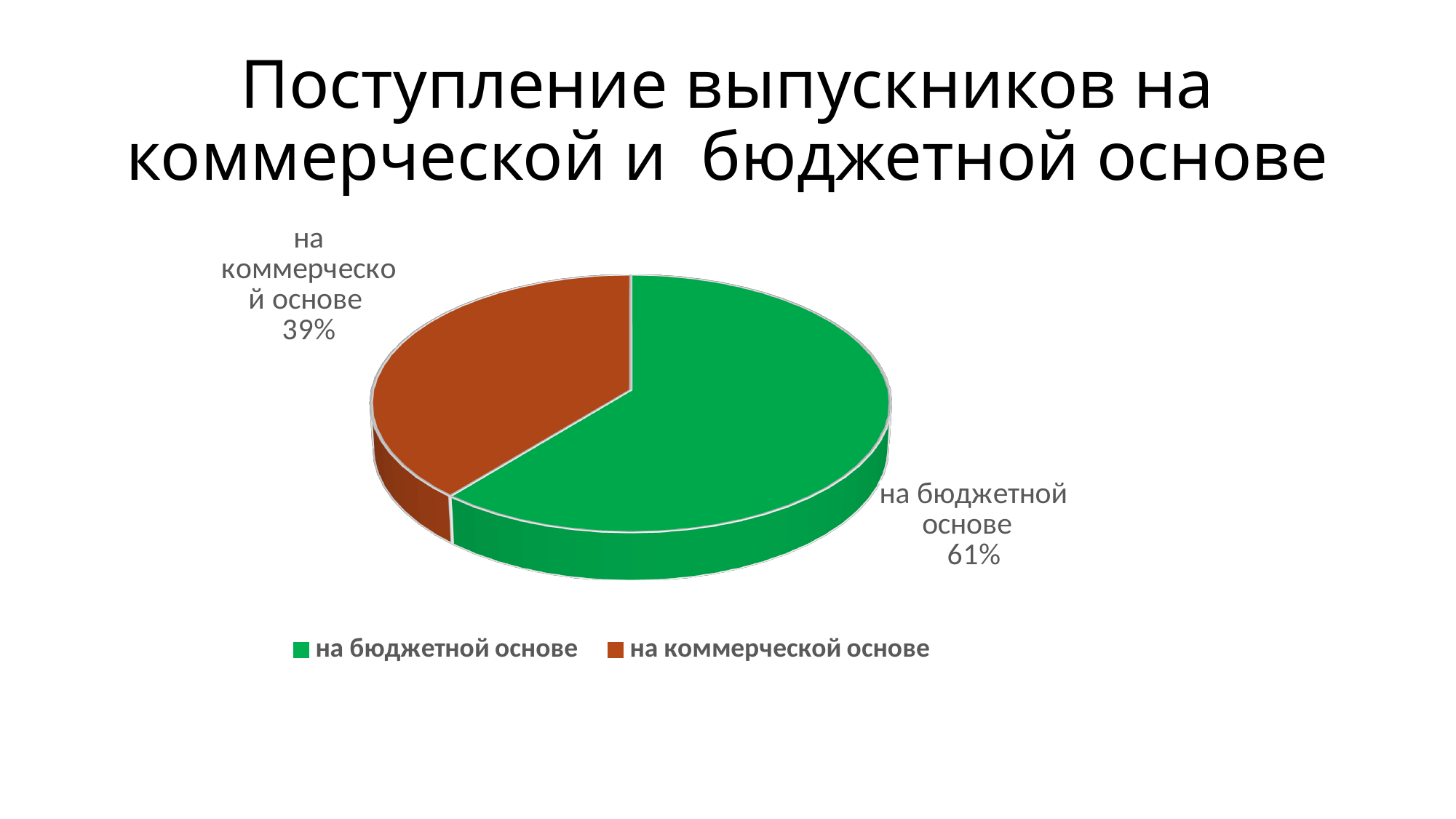
What is the difference in percentage points between the "на бюджетной основе" and "на коммерческой основе" slices? 22 Which slice of the pie is the largest? на бюджетной основе How many entries does the legend list? 2 What colour is the "на бюджетной основе" slice? Green How many slices does the pie chart have? 2 What share of the pie is labelled "на коммерческой основе"? 39% What share of the pie is labelled "на бюджетной основе"? 61% What is the title of the slide? Поступление выпускников на коммерческой и бюджетной основе Which slice of the pie is the smallest? на коммерческой основе What kind of chart is shown on the slide? Pie chart Which is larger: the share for "на бюджетной основе" or for "на коммерческой основе"? на бюджетной основе